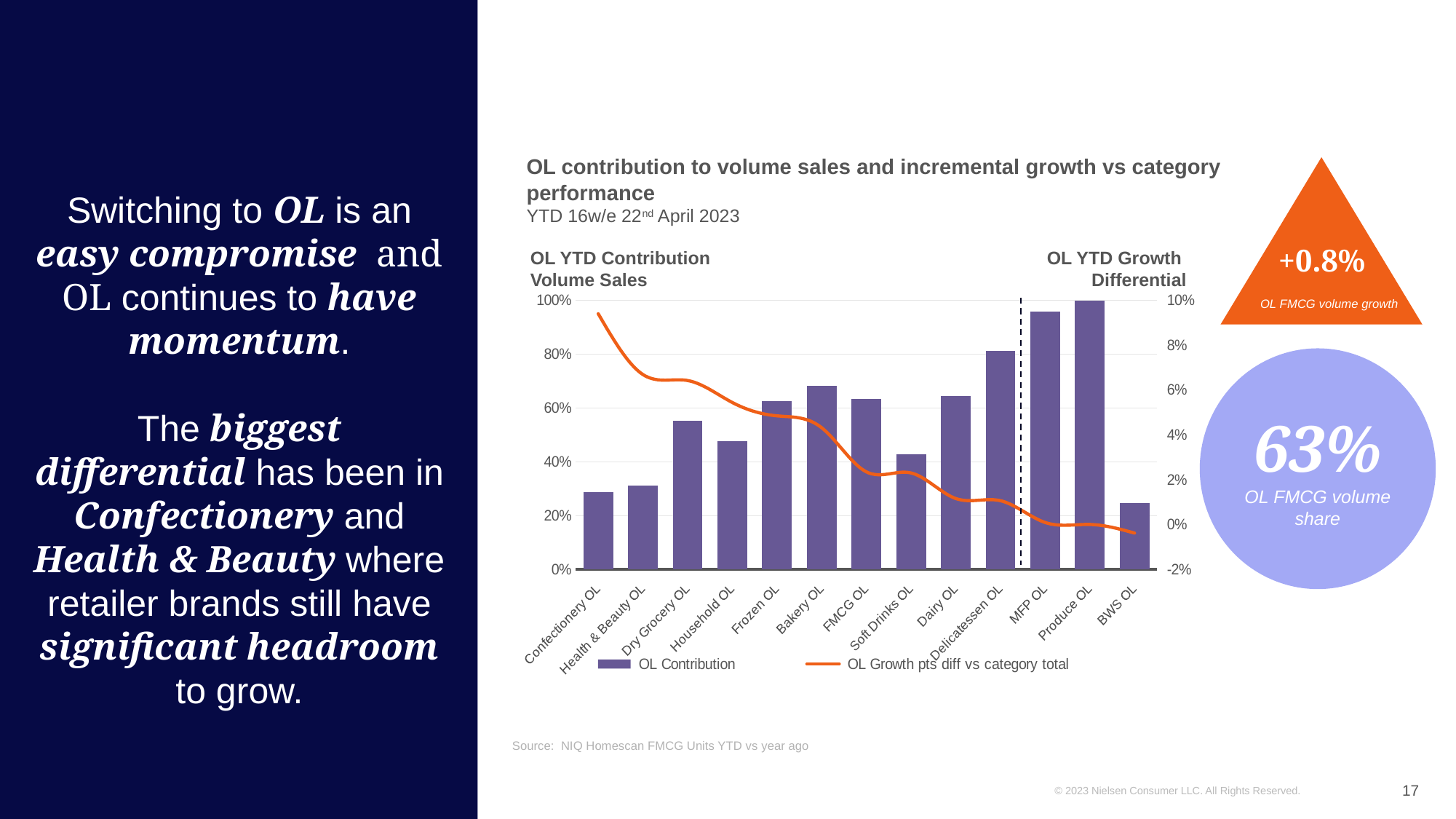
Which category has the highest OL Contribution bar? Produce OL Is the OL Contribution value for Confectionery OL greater or less than 40%? less Is the OL Contribution value for MFP OL greater or less than 80%? greater How many categories are shown along the x axis of the chart? 13 Is the OL Contribution value for Dry Grocery OL greater or less than 40%? greater Which has the larger OL Contribution bar, Dry Grocery OL or Household OL? Dry Grocery OL What is the title of the chart? OL contribution to volume sales and incremental growth vs category performance Does the OL Growth pts diff vs category total line generally rise or fall from left to right across the categories? Fall At which category is the OL Growth pts diff vs category total line at its highest? Confectionery OL How many series does the chart legend list? 2 What kind of chart is shown on the slide? A combined bar and line chart